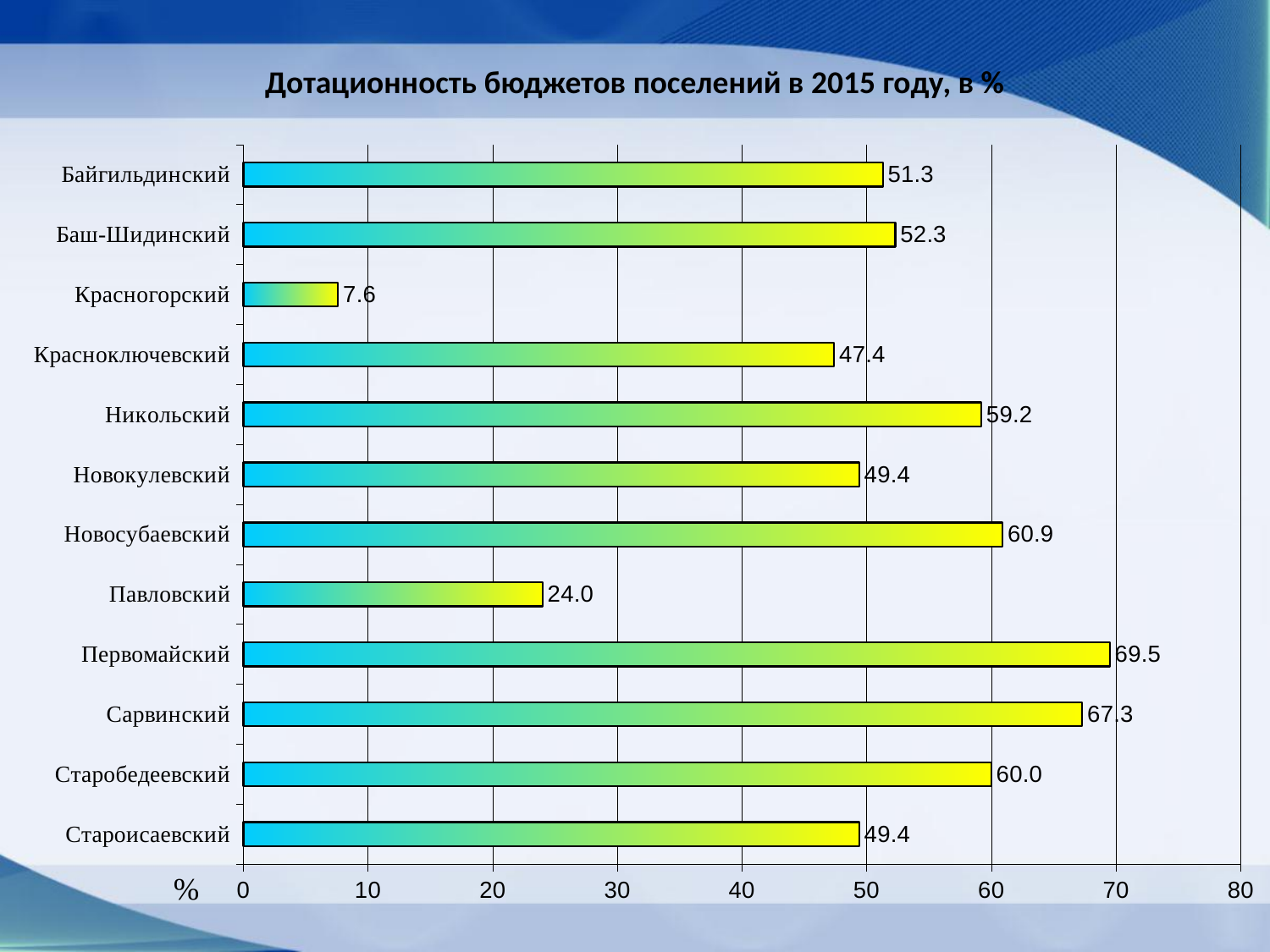
How many settlements are shown in the chart? 12 Which is larger, the value for Никольский or the value for Новосубаевский? Новосубаевский What is the value for Павловский? 24.0 Which settlement has the highest value? Первомайский Which settlement has the lowest value? Красногорский What is the maximum value shown on the horizontal axis? 80 Is the value for Красноключевский greater or less than 50? less What is the value for Красногорский? 7.6 What is the value for Первомайский? 69.5 What kind of chart is shown on the slide? bar chart What is the title of the chart? Дотационность бюджетов поселений в 2015 году, в % What is the difference between the values for Сарвинский and Старобедеевский? 7.3